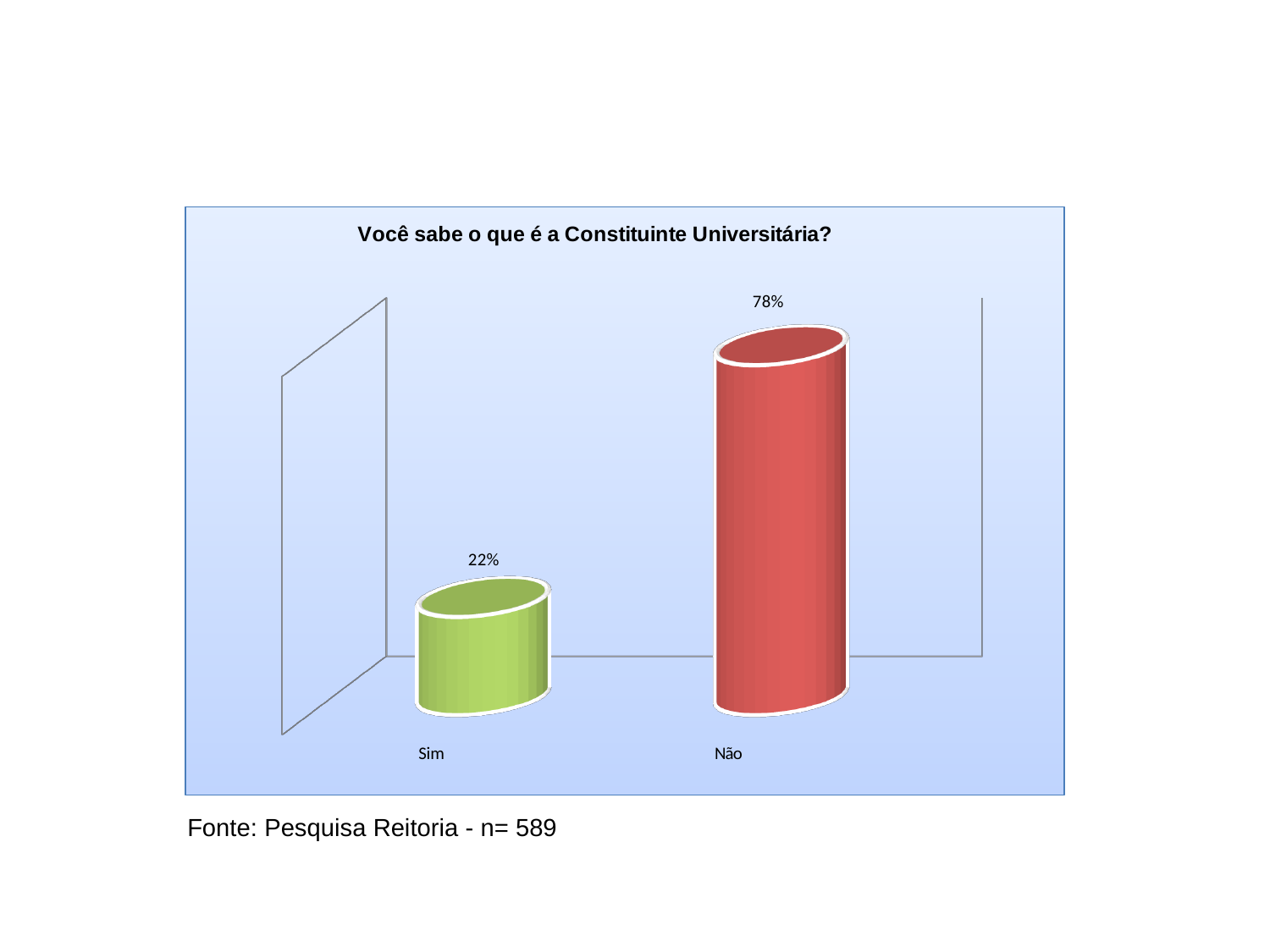
What is the value for Não? 78% What is the value for Sim? 22% Which category has the highest value? Não Which category has the lowest value? Sim What is the difference between the values for Não and Sim? 56% What kind of chart is shown on the slide? Bar chart What colour is the bar for Não? Red Which is larger, the value for Sim or the value for Não? Não What is the total of the values for Sim and Não? 100% What is the title of the chart? Você sabe o que é a Constituinte Universitária? How many categories are shown in the chart? 2